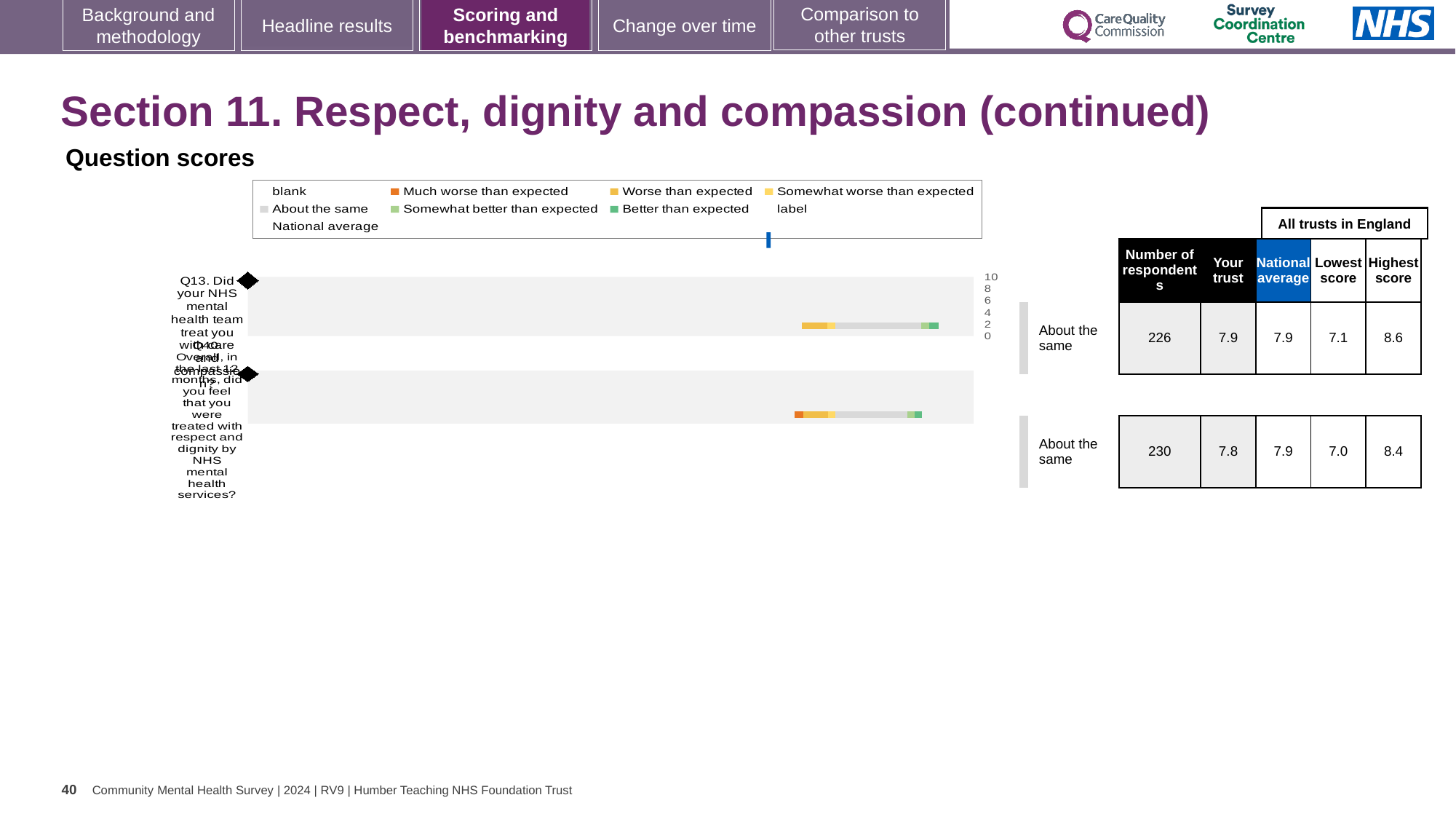
Which legend entry is shown in orange? Much worse than expected What kind of chart is shown under 'Question scores'? bar chart How is the trust's result for Q13 categorised relative to expectations? About the same How many survey questions are plotted in the chart? 2 What is the lowest score among all trusts in England for Q40? 7.0 What is the number of respondents for Q40? 230 What is the difference between the highest and lowest scores for Q40? 1.4 What is the national average score for Q13? 7.9 What is the 'Your trust' score for Q40 (respect and dignity)? 7.8 What is the 'Your trust' score for Q13 (care and compassion)? 7.9 What is the highest score among all trusts in England for Q13? 8.6 Which question has the higher 'Your trust' score, Q13 or Q40? Q13